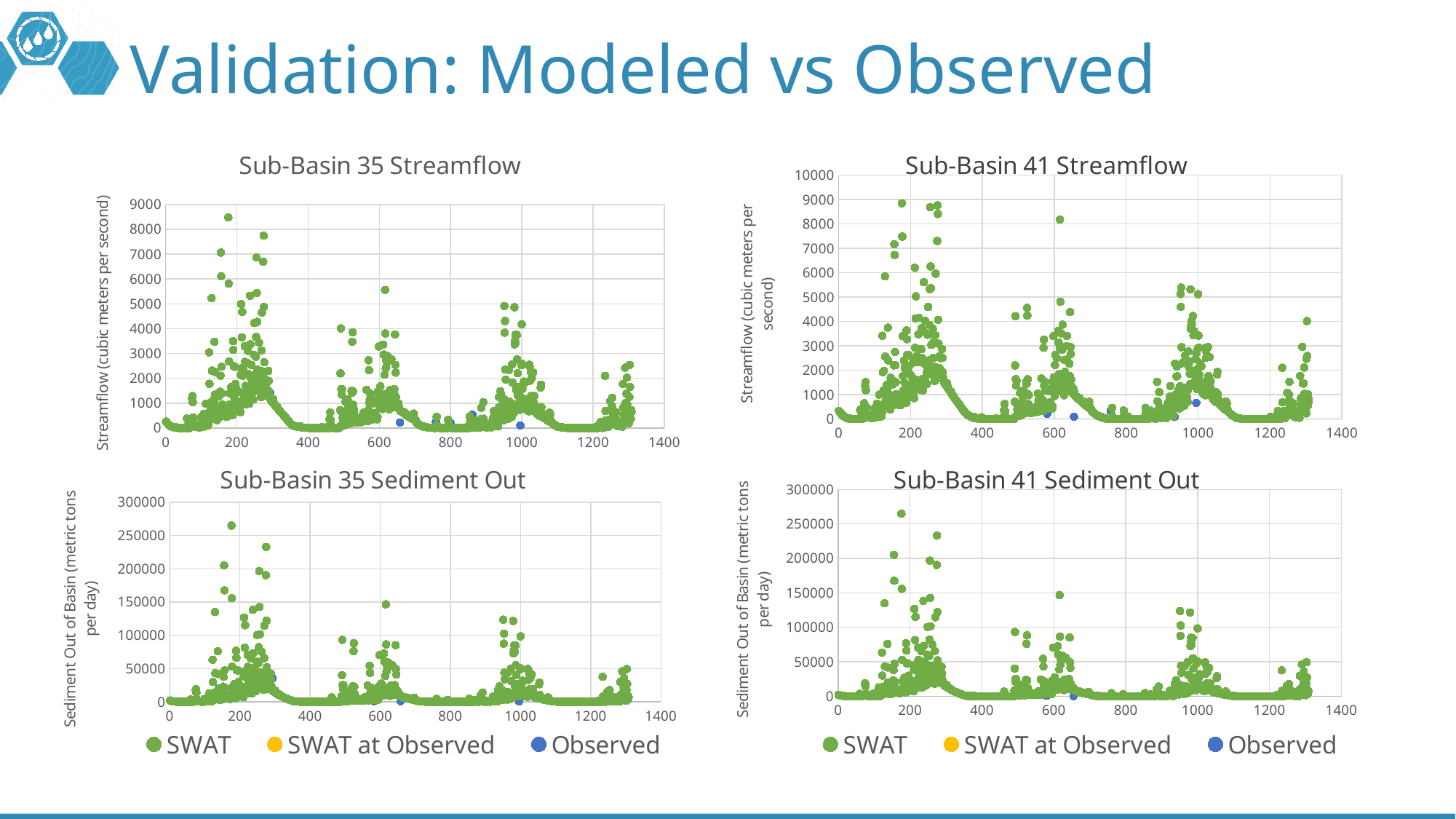
In the Sub-Basin 41 Sediment Out chart, is the highest SWAT point greater or less than 250000? greater How many series does the legend list for the Sub-Basin 41 Sediment Out chart? 3 In the Sub-Basin 41 Streamflow chart, is the highest SWAT point between x=800 and x=1200 greater or less than 6000? less In the Sub-Basin 35 Sediment Out chart, is the highest SWAT point greater or less than 250000? greater What is the highest value shown on the y axis of the Sub-Basin 41 Streamflow chart? 10000 How many charts are shown on the slide? 4 What kind of chart is the Sub-Basin 35 Streamflow chart? scatter chart Which series is shown in blue in the legend of the Sub-Basin 35 Sediment Out chart? Observed